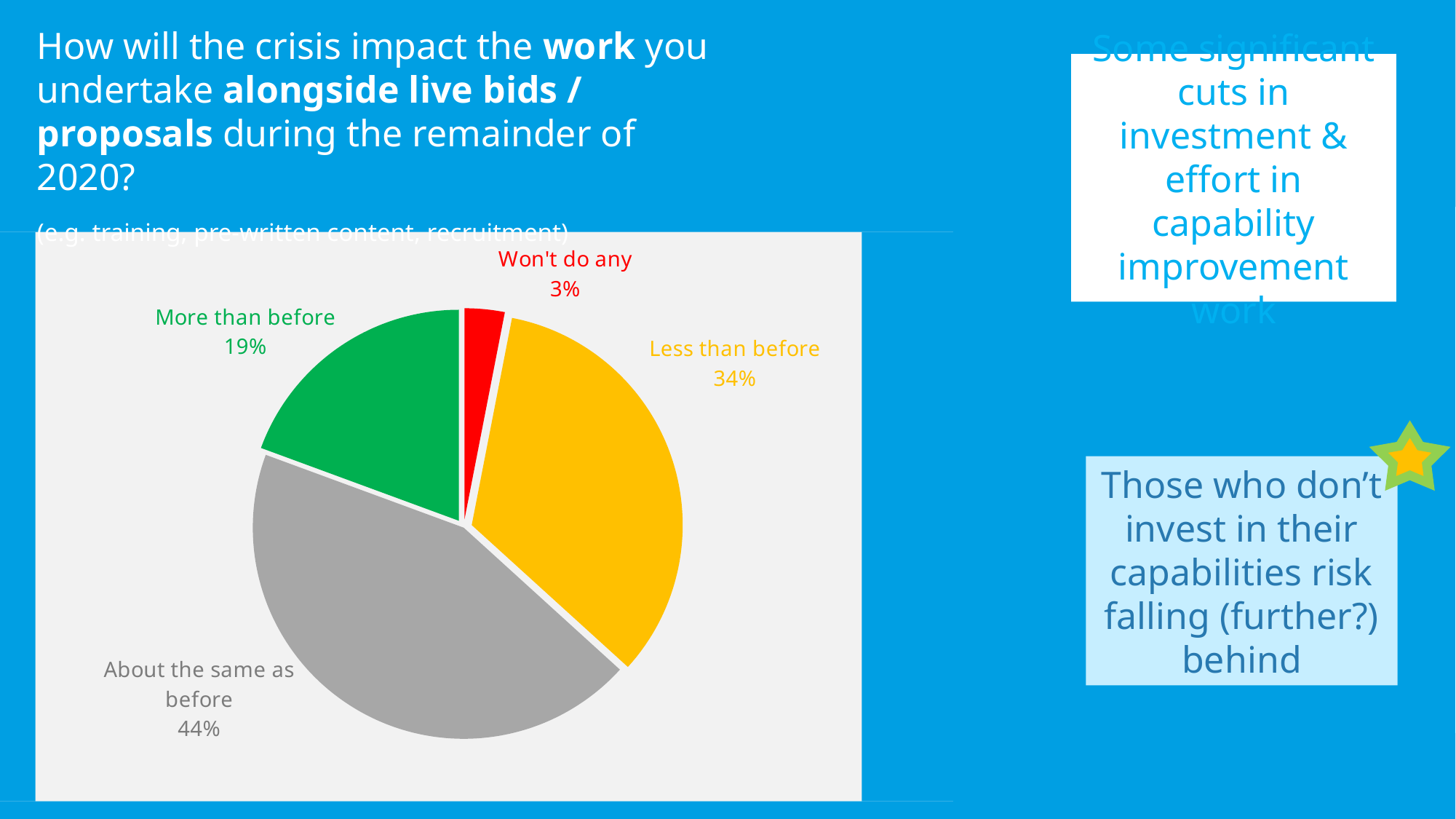
What percentage of respondents said they won't do any? 3% What colour is the 'More than before' slice? green Which category has the smallest share of the pie? Won't do any What percentage of respondents said they will do less than before? 34% What is the difference in percentage points between 'About the same as before' and 'Less than before'? 10 Which is larger: 'More than before' or 'Less than before'? Less than before What percentage of respondents said they will do about the same as before? 44% What percentage of respondents said they will do more than before? 19% Which category has the largest share of the pie? About the same as before How many slices does the pie chart have? 4 What kind of chart is shown on the slide? pie chart What colour is the 'Less than before' slice? yellow